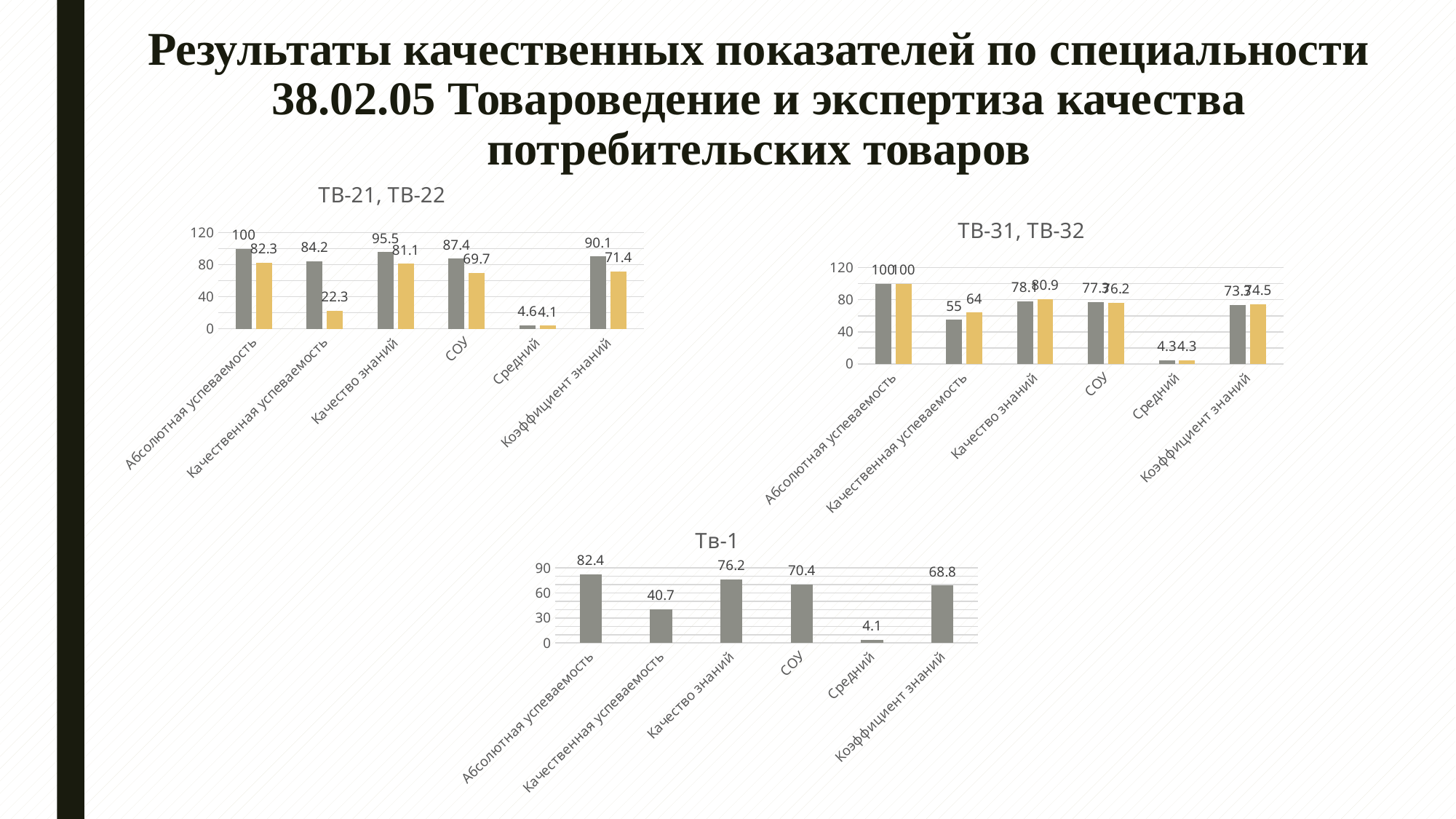
In the chart titled "Тв-1", which category has the highest value? Абсолютная успеваемость How many categories are shown on the x axis of the chart titled "Тв-1"? 6 In the chart titled "ТВ-31, ТВ-32", which is larger for Качественная успеваемость, the gray bar or the yellow bar? the yellow bar What type of chart is the chart titled "ТВ-31, ТВ-32"? bar chart In the chart titled "ТВ-21, ТВ-22", what is the value of the gray bar for Коэффициент знаний? 90.1 In the chart titled "Тв-1", what is the value for Абсолютная успеваемость? 82.4 In the chart titled "ТВ-21, ТВ-22", what is the difference between the gray and yellow bars for СОУ? 17.7 In the chart titled "Тв-1", what is the value for Качественная успеваемость? 40.7 In the chart titled "ТВ-31, ТВ-32", what is the value of the yellow bar for Качественная успеваемость? 64 In the chart titled "Тв-1", what is the difference between the values for Качество знаний and Коэффициент знаний? 7.4 In the chart titled "Тв-1", which category has the lowest value? Средний In the chart titled "ТВ-21, ТВ-22", what is the value of the yellow bar for Качественная успеваемость? 22.3